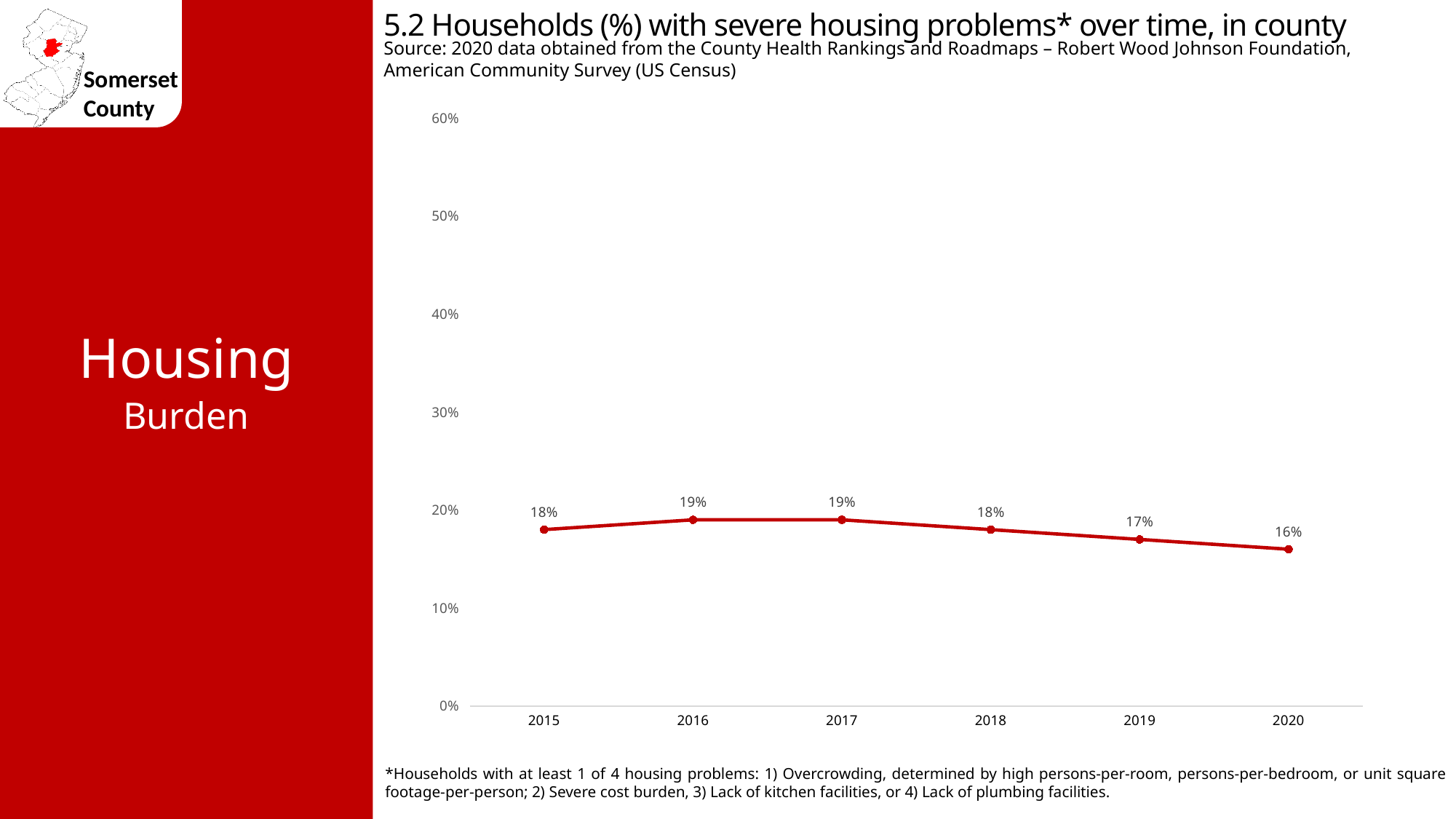
What is the title of the chart? 5.2 Households (%) with severe housing problems* over time, in county Which year has the lowest percentage of households with severe housing problems? 2020 What is the value shown for 2020? 16% What is the value shown for 2019? 17% Which is larger, the value for 2018 or the value for 2019? 2018 How many years are plotted on the chart? 6 What is the highest value shown on the vertical axis? 60% What kind of chart is shown on the slide? line chart What is the difference between the 2016 value and the 2020 value? 3% Do the values rise or fall from 2017 to 2020? fall Is the value for 2017 greater or less than 30%? less What percentage of households had severe housing problems in 2015? 18%